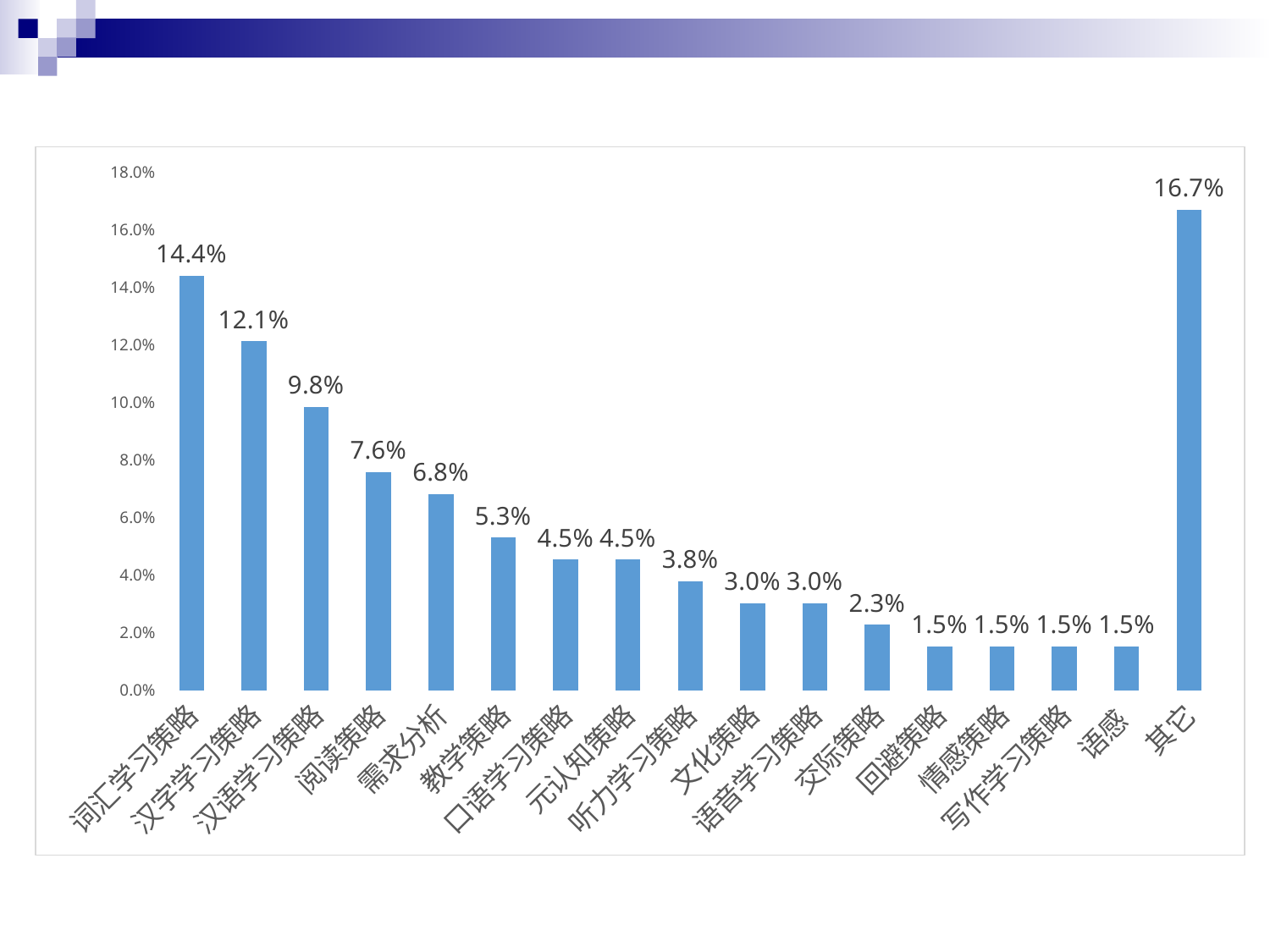
Which is larger, the value for 阅读策略 or the value for 教学策略? 阅读策略 What is the value for 听力学习策略? 3.8% Which category has the highest value? 其它 What is the value for 词汇学习策略? 14.4% What is the value for 交际策略? 2.3% What kind of chart is shown on the slide? bar chart What is the difference between the values for 其它 and 词汇学习策略? 2.3% How many categories are shown on the x axis? 17 What is the value for 其它? 16.7% Is the value for 汉字学习策略 greater or less than 10.0%? greater What is the value for 需求分析? 6.8% What is the difference between the values for 汉字学习策略 and 汉语学习策略? 2.3%